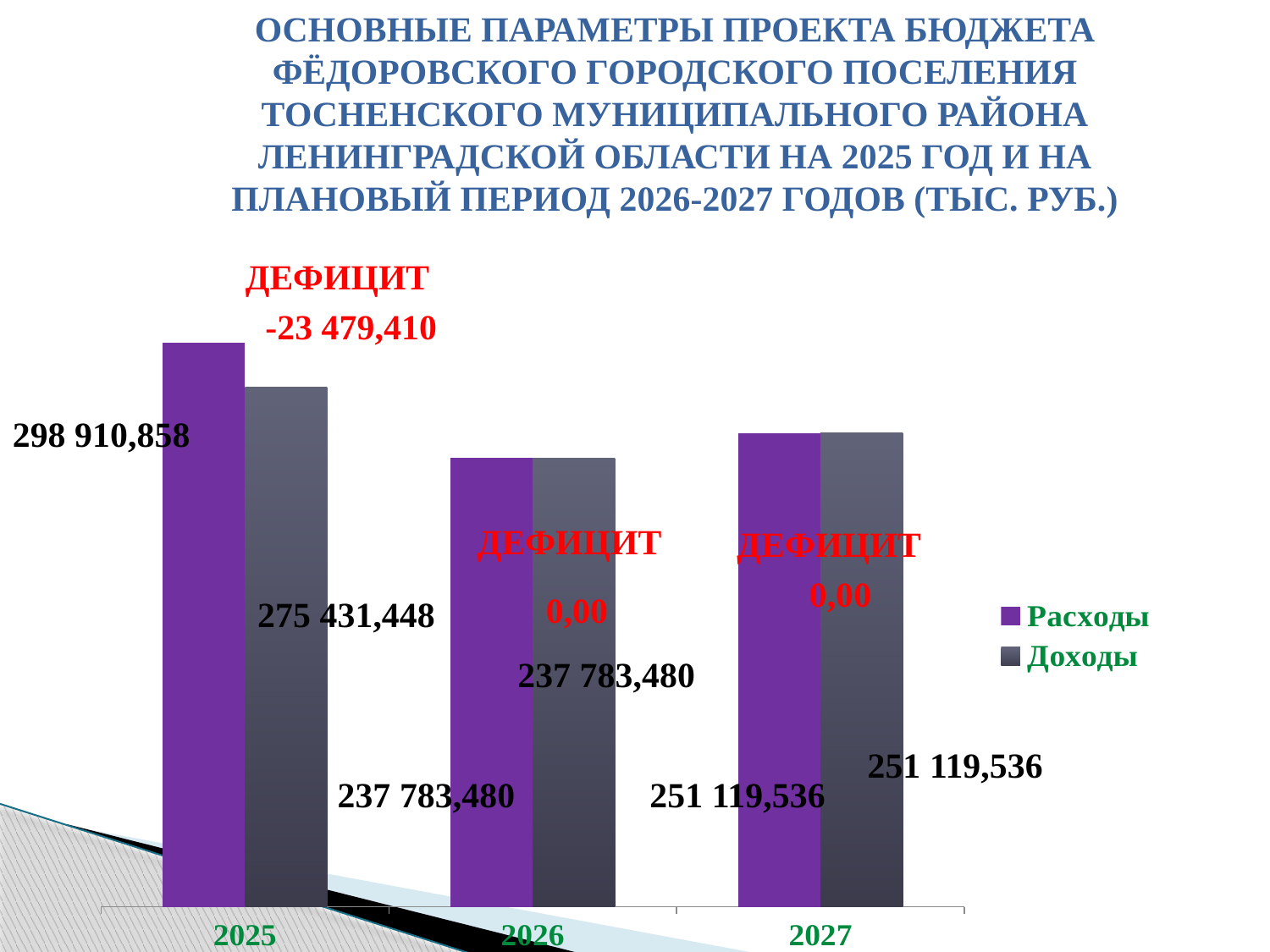
What deficit (ДЕФИЦИТ) is shown for 2025? -23 479,410 How many series does the legend list? 2 What deficit (ДЕФИЦИТ) is shown for 2027? 0,00 What is the value of Доходы for 2025? 275 431,448 What kind of chart is shown on the slide? Bar chart What is the value of Расходы for 2025? 298 910,858 What is the value of Доходы for 2027? 251 119,536 In which year is Расходы the highest? 2025 Which is larger in 2025, Расходы or Доходы? Расходы In which year is Доходы the lowest? 2026 How many years are shown on the x axis? 3 What is the value of Расходы for 2026? 237 783,480